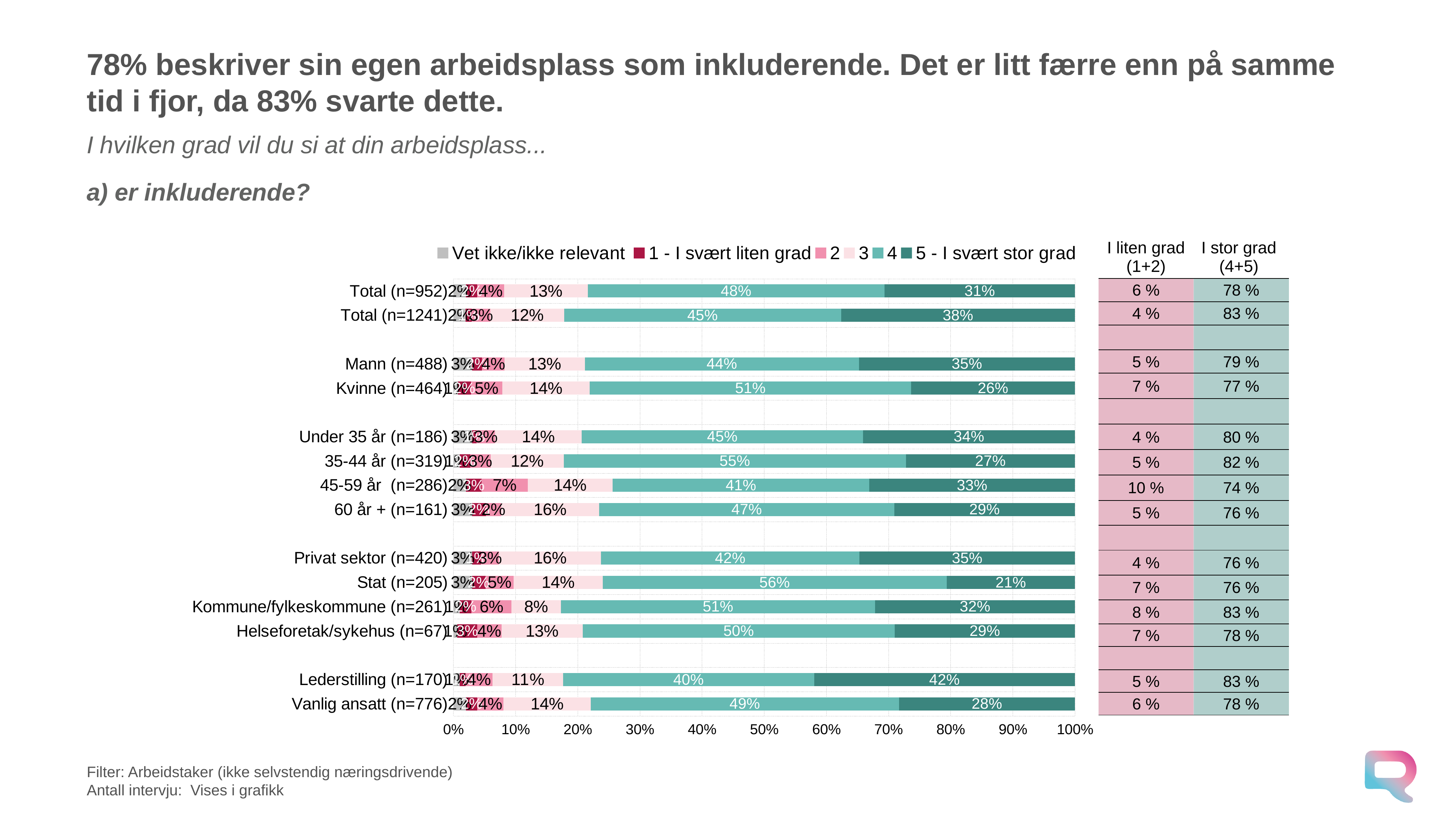
Which category has the lowest '5 - I svært stor grad' value? Stat (n=205) What is the value of the '3' segment for Kommune/fylkeskommune (n=261)? 8% What is the value of the '4' segment for Stat (n=205)? 56% What kind of chart is shown on the slide? bar chart How many categories (bars) are plotted in the chart? 14 Which category has the highest '5 - I svært stor grad' value? Lederstilling (n=170) What is the value of the '5 - I svært stor grad' segment for Lederstilling (n=170)? 42% How many series does the legend of the chart list? 6 What is the difference between the '5 - I svært stor grad' values for Total (n=1241) and Total (n=952)? 7% What is the value of the '3' segment for 60 år + (n=161)? 16% Which has the larger '4' segment, Mann (n=488) or Kvinne (n=464)? Kvinne (n=464) What is the value of the '4' segment for Total (n=952)? 48%